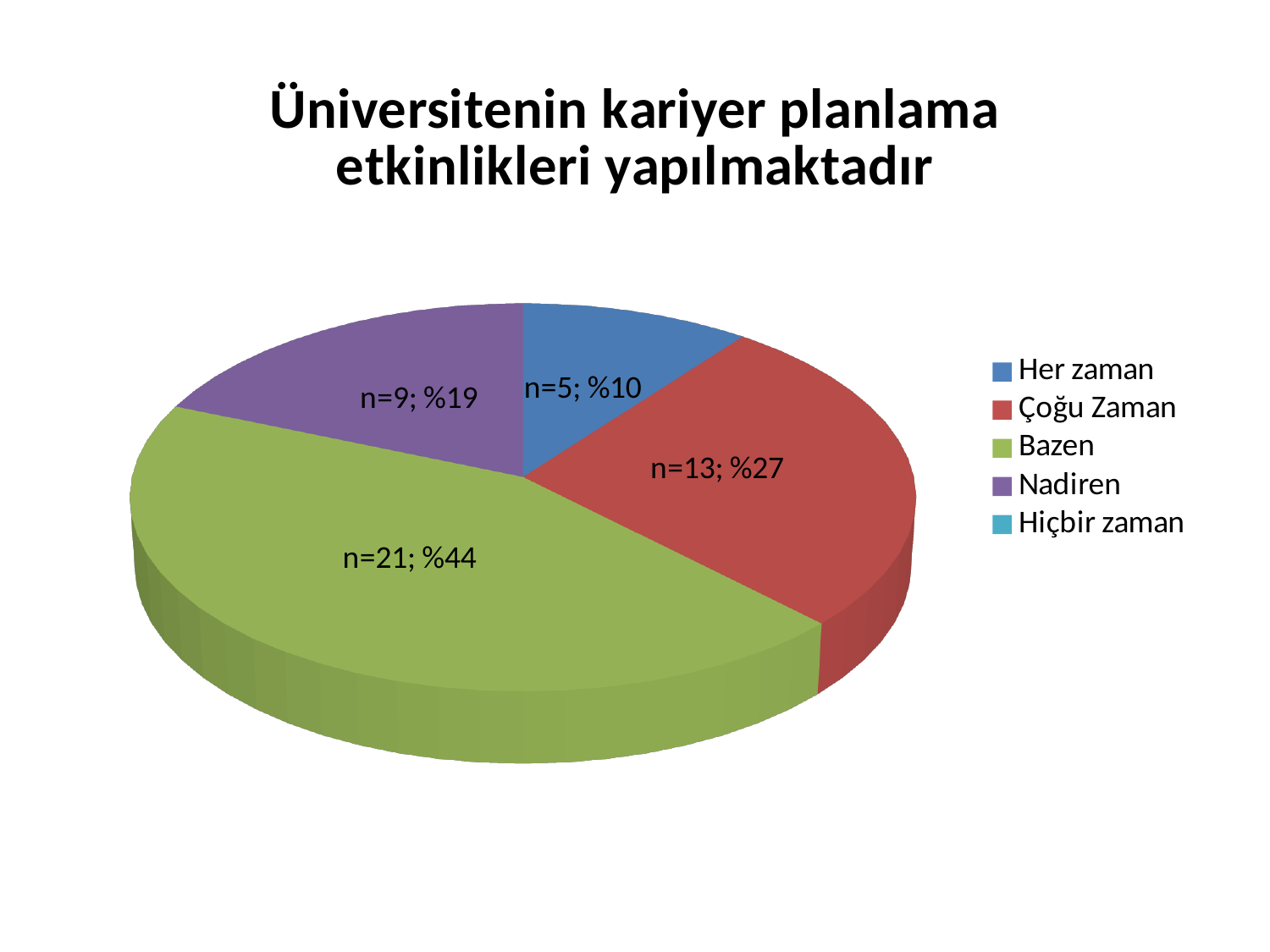
Which is larger, the share for Nadiren or the share for Her zaman? Nadiren Among the slices with visible labels, which category has the smallest share? Her zaman What is the title of the chart? Üniversitenin kariyer planlama etkinlikleri yapılmaktadır What percentage share does the Nadiren slice have? %19 What colour is the Bazen slice? green What percentage share does the Çoğu Zaman slice have? %27 What kind of chart is shown on the slide? pie chart How many entries does the legend list? 5 Which category has the largest slice of the pie? Bazen What is the count (n) for the Her zaman slice? n=5 What is the difference in count (n) between Bazen and Çoğu Zaman? 8 What is the count (n) for the Bazen slice? n=21